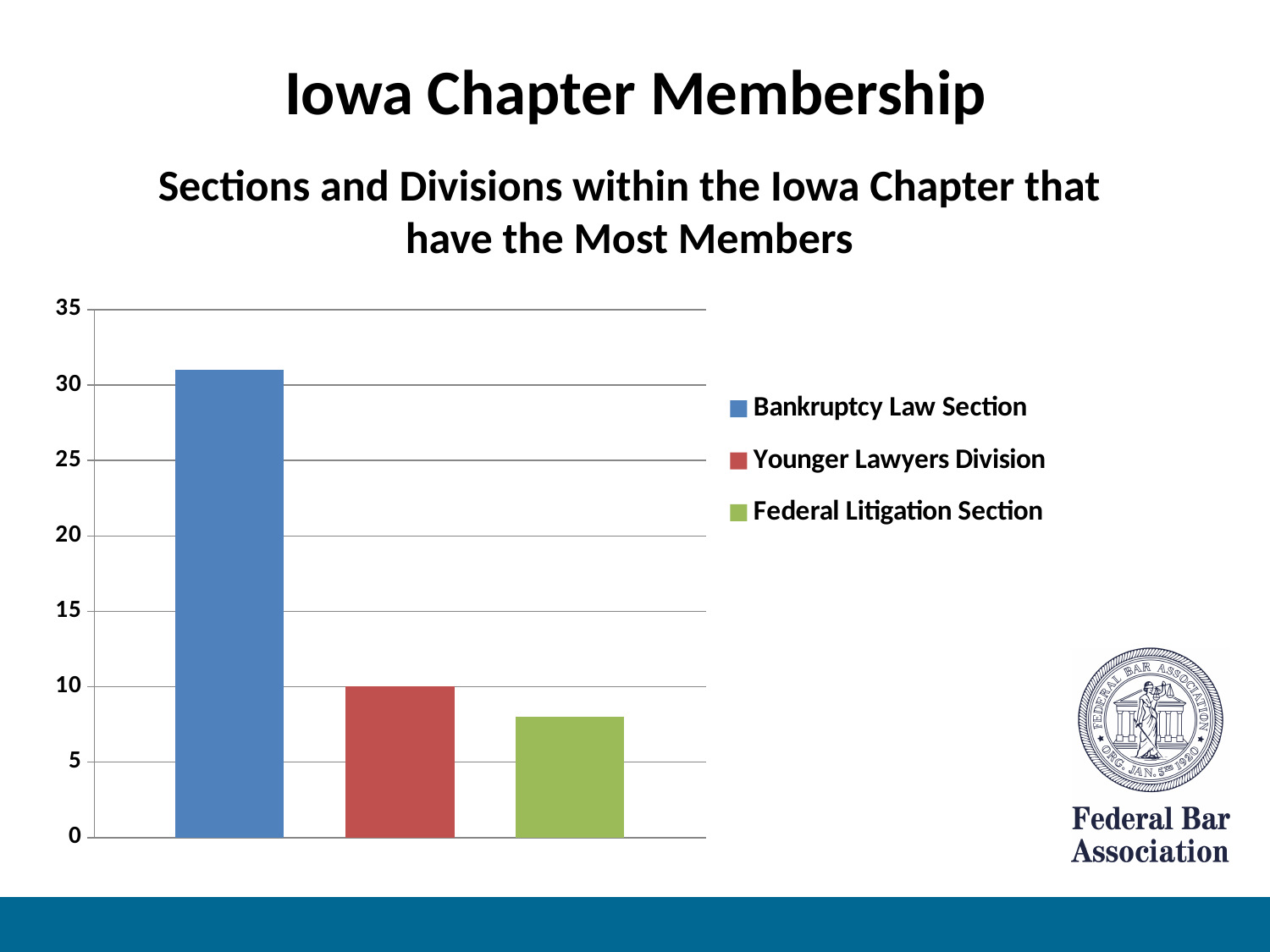
Is the value for the Bankruptcy Law Section greater or less than 35? less What colour is the bar for the Federal Litigation Section? green Is the value for the Federal Litigation Section greater or less than 10? less Which section or division has the lowest membership in the chart? Federal Litigation Section Which is larger, the value for the Younger Lawyers Division or the Federal Litigation Section? Younger Lawyers Division Is the value for the Bankruptcy Law Section greater or less than 30? greater How many series does the legend list? 3 What kind of chart is shown on the slide? bar chart How many bars are plotted in the chart? 3 What is the value for the Younger Lawyers Division? 10 What is the title of the chart? Sections and Divisions within the Iowa Chapter that have the Most Members Which section or division has the highest membership in the chart? Bankruptcy Law Section